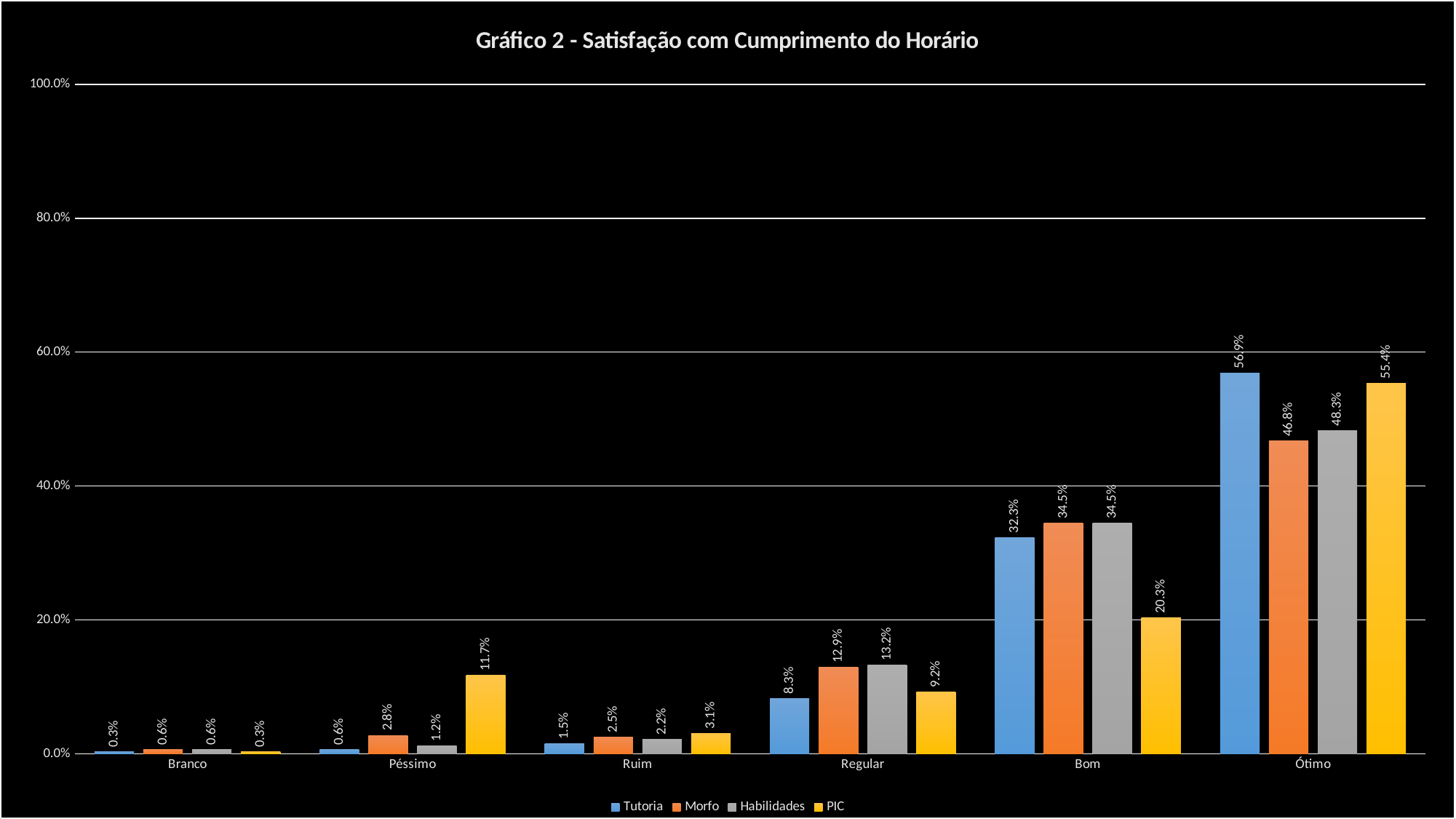
Which series has the lowest value in the Bom category? PIC In the Regular category, which is larger: the Morfo value or the PIC value? Morfo What kind of chart is shown on the slide? Bar chart Is the value for Habilidades in the Ótimo category greater or less than 40.0%? greater How many categories are shown on the x axis? 6 What is the value for PIC in the Péssimo category? 11.7% What is the value for Tutoria in the Ótimo category? 56.9% Which category has the highest value for the PIC series? Ótimo What is the difference between the Tutoria and Morfo values in the Ótimo category? 10.1% How many series does the legend list? 4 What is the value for Habilidades in the Regular category? 13.2% What is the value for Morfo in the Bom category? 34.5%